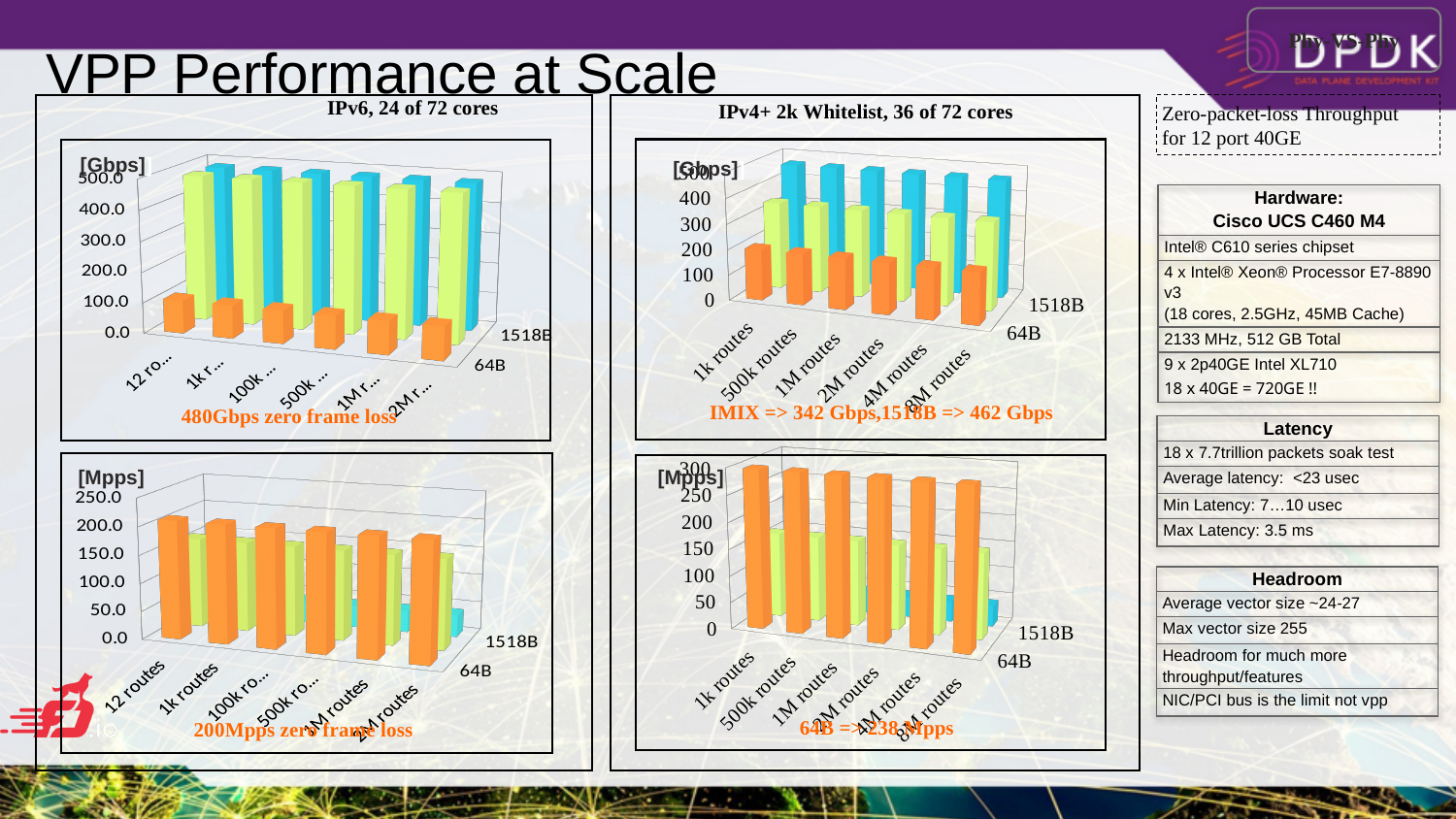
In the top-left [Gbps] chart, is the 64B value for 12 routes greater or less than 200.0? less What is the title of the top-right chart? IPv4+ 2k Whitelist, 36 of 72 cores In the bottom-left [Mpps] chart, is the 1518B value for 2M routes greater or less than 100.0? less How many route categories are shown on the x axis of the top-right chart titled 'IPv4+ 2k Whitelist, 36 of 72 cores'? 6 What kind of chart is the top-left chart titled 'IPv6, 24 of 72 cores'? bar chart In the top-left [Gbps] chart, is the 1518B value for 12 routes greater or less than 400.0? greater In the top-left [Gbps] chart, which is larger for 12 routes: the 64B value or the 1518B value? 1518B How many route categories are shown on the x axis of the bottom-left [Mpps] chart? 6 In the bottom-left [Mpps] chart, which is larger for 12 routes: the 64B value or the 1518B value? 64B